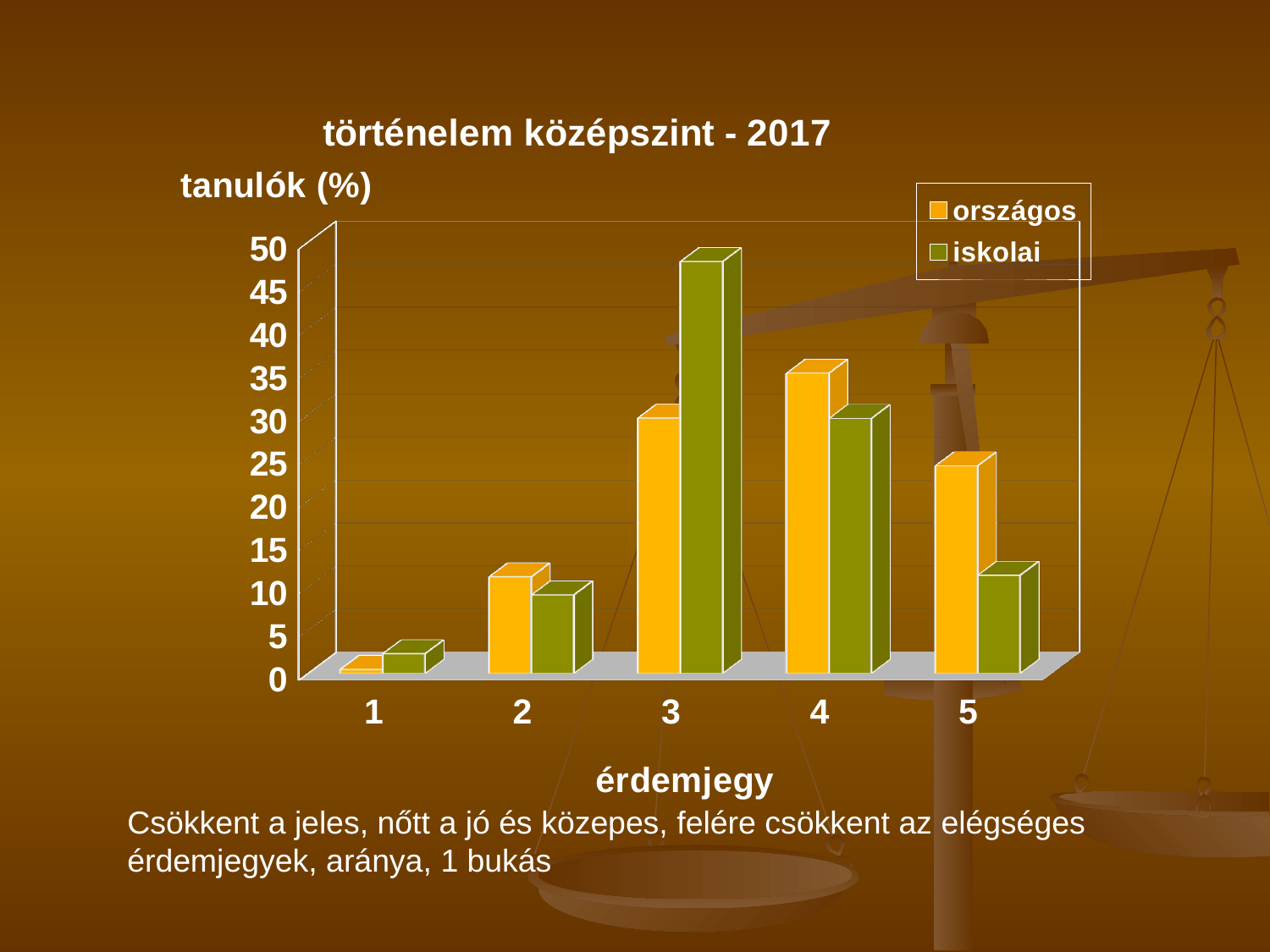
For which grade is the iskolai value highest? 3 Which two series are listed in the legend? országos, iskolai Is the országos value for grade 5 greater or less than 30? less For grade 5, which series has the larger value, országos or iskolai? országos How many grade categories (érdemjegy) are shown on the x axis? 5 How many series does the legend list? 2 What kind of chart is shown on the slide? bar chart Is the iskolai value for grade 3 greater or less than 40? greater For which grade is the országos value highest? 4 For which grade is the országos value lowest? 1 What is the title of the chart? történelem középszint - 2017 For grade 3, which series has the larger value, országos or iskolai? iskolai